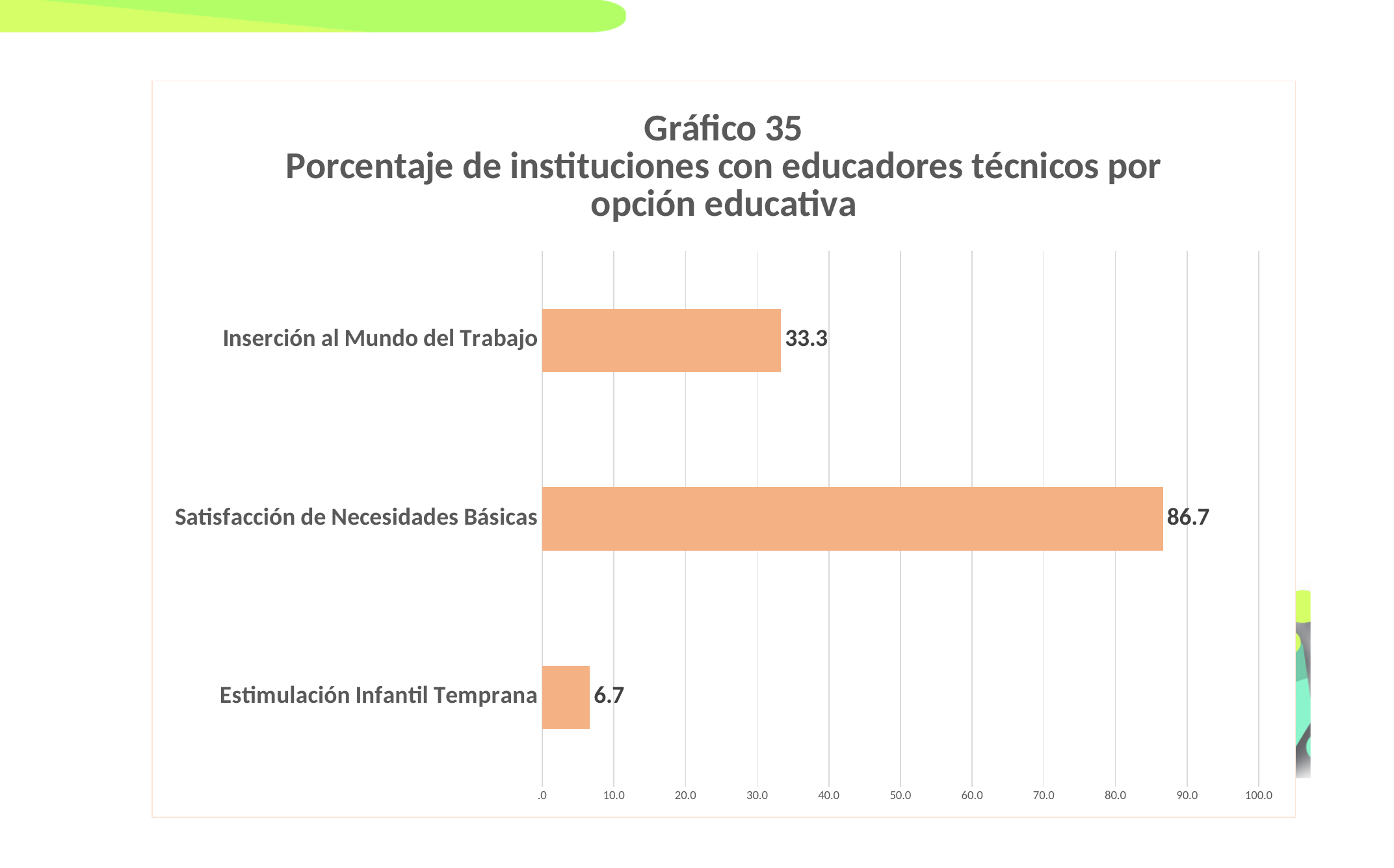
How many categories are shown in the chart? 3 What is the value for Estimulación Infantil Temprana? 6.7 What is the value for Inserción al Mundo del Trabajo? 33.3 Which is larger, the value for Inserción al Mundo del Trabajo or the value for Estimulación Infantil Temprana? Inserción al Mundo del Trabajo Which category has the highest value? Satisfacción de Necesidades Básicas What is the difference between the values for Inserción al Mundo del Trabajo and Estimulación Infantil Temprana? 26.6 What kind of chart is shown on the slide? bar chart What is the number of the chart given in its title? Gráfico 35 What is the difference between the values for Satisfacción de Necesidades Básicas and Inserción al Mundo del Trabajo? 53.4 Is the value for Satisfacción de Necesidades Básicas greater or less than 80.0? greater Which category has the lowest value? Estimulación Infantil Temprana What is the value for Satisfacción de Necesidades Básicas? 86.7